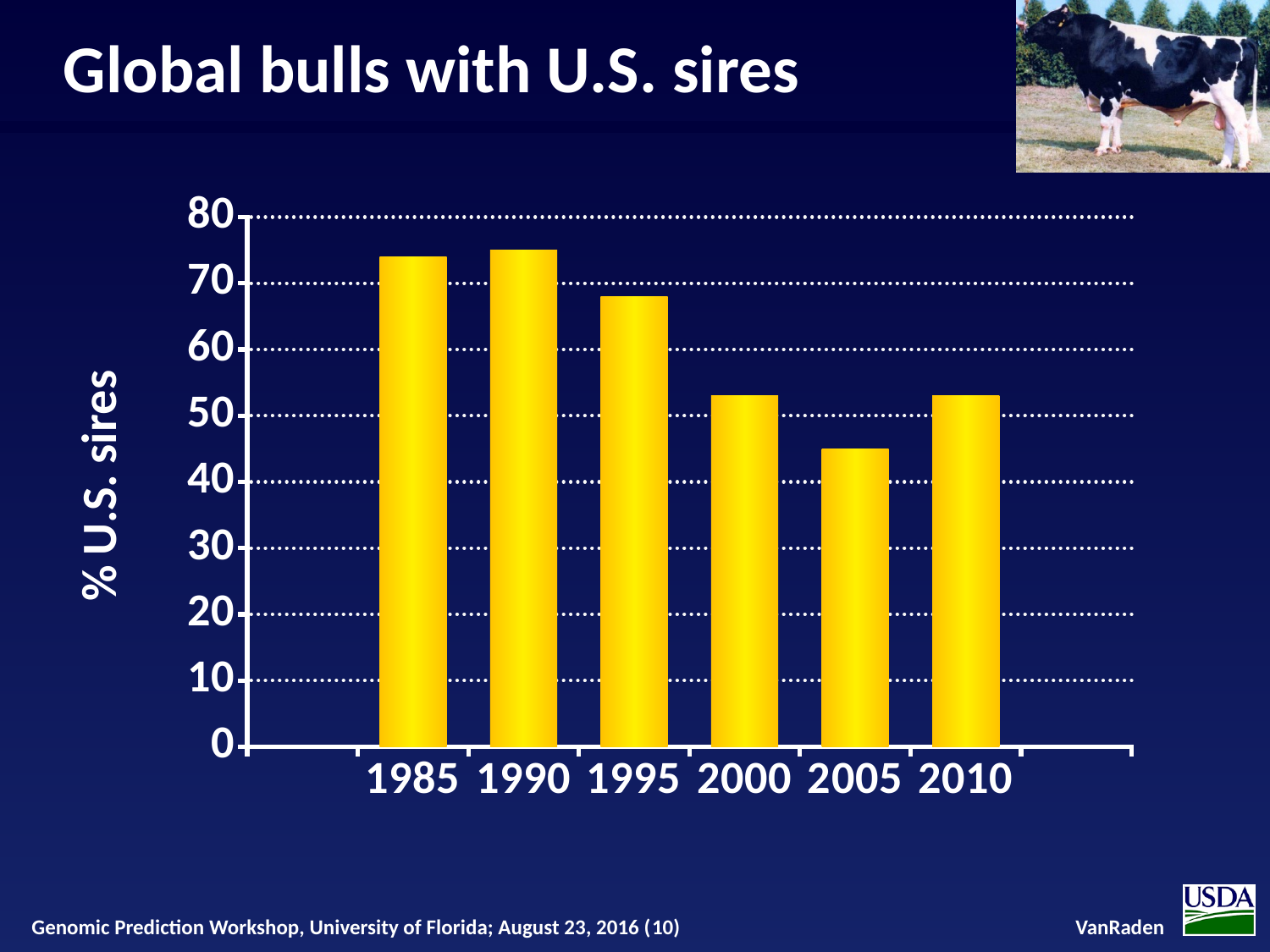
What kind of chart is shown on the slide? bar chart Is the value for 2000 greater or less than 50? greater Is the value for 2005 greater or less than 50? less Which year has the lowest percentage of U.S. sires? 2005 Is the value for 1995 greater or less than 70? less What is the label on the y axis of the chart? % U.S. sires Do the values generally rise or fall from 1985 to 2005? fall Which is larger, the value for 1995 or the value for 2000? 1995 How many years are shown on the x axis of the chart? 6